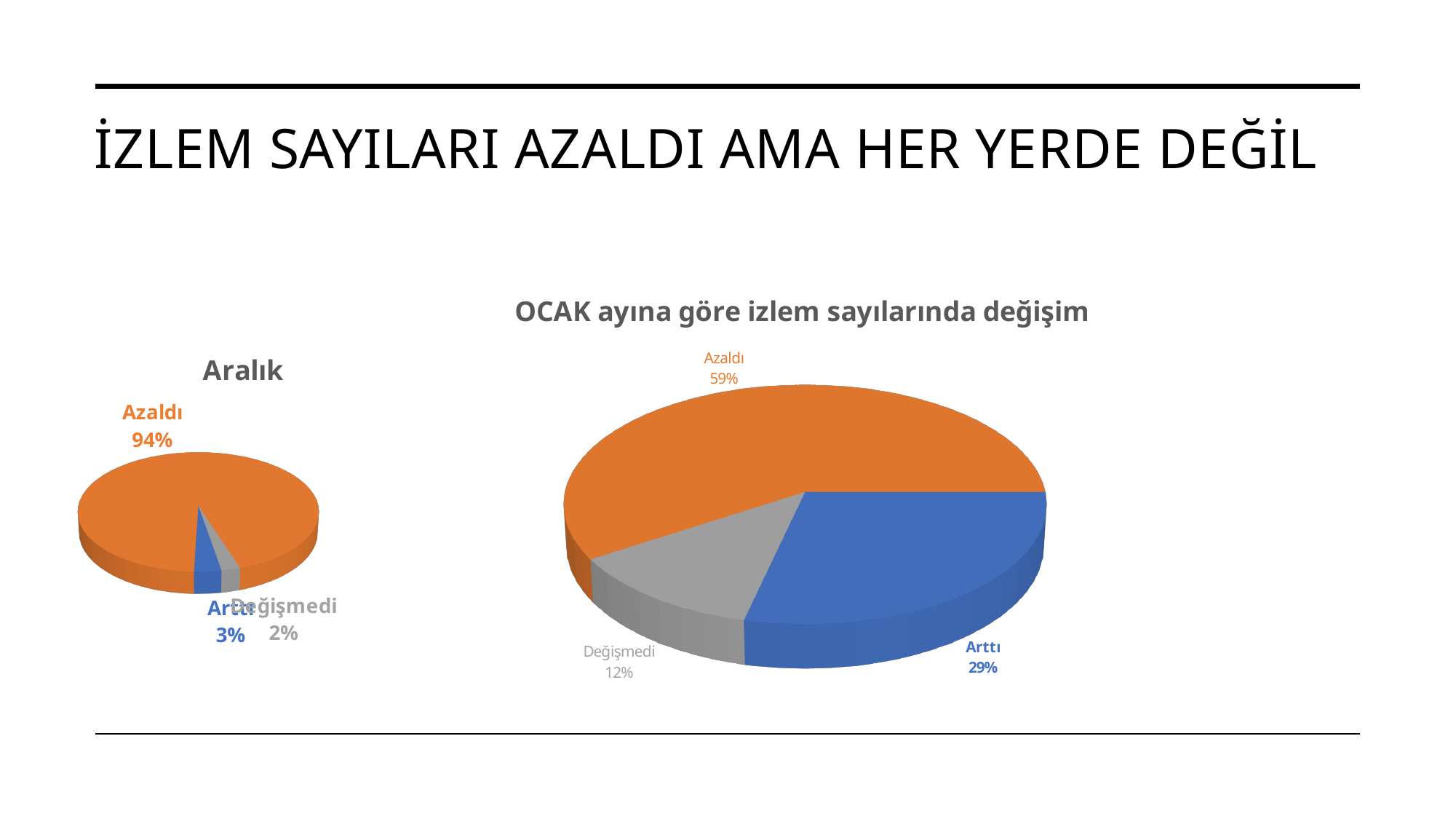
In the "Aralık" pie chart, what share does the "Azaldı" slice have? 94% In the "OCAK ayına göre izlem sayılarında değişim" pie chart, what is the value for "Arttı"? 29% In the "OCAK ayına göre izlem sayılarında değişim" pie chart, what is the difference between the "Azaldı" and "Arttı" shares? 30% In the "OCAK ayına göre izlem sayılarında değişim" pie chart, which category has the largest slice? Azaldı In the "OCAK ayına göre izlem sayılarında değişim" pie chart, what share does "Azaldı" have? 59% In the "OCAK ayına göre izlem sayılarında değişim" pie chart, what is the value for "Değişmedi"? 12% How many slices does the "Aralık" pie chart have? 3 In the "OCAK ayına göre izlem sayılarında değişim" pie chart, which category has the smallest slice? Değişmedi In the "Aralık" pie chart, what is the value for "Arttı"? 3% What type of chart is the chart titled "OCAK ayına göre izlem sayılarında değişim"? Pie chart In the "Aralık" pie chart, what is the value for "Değişmedi"? 2% In the "Aralık" pie chart, which category has the smallest slice? Değişmedi